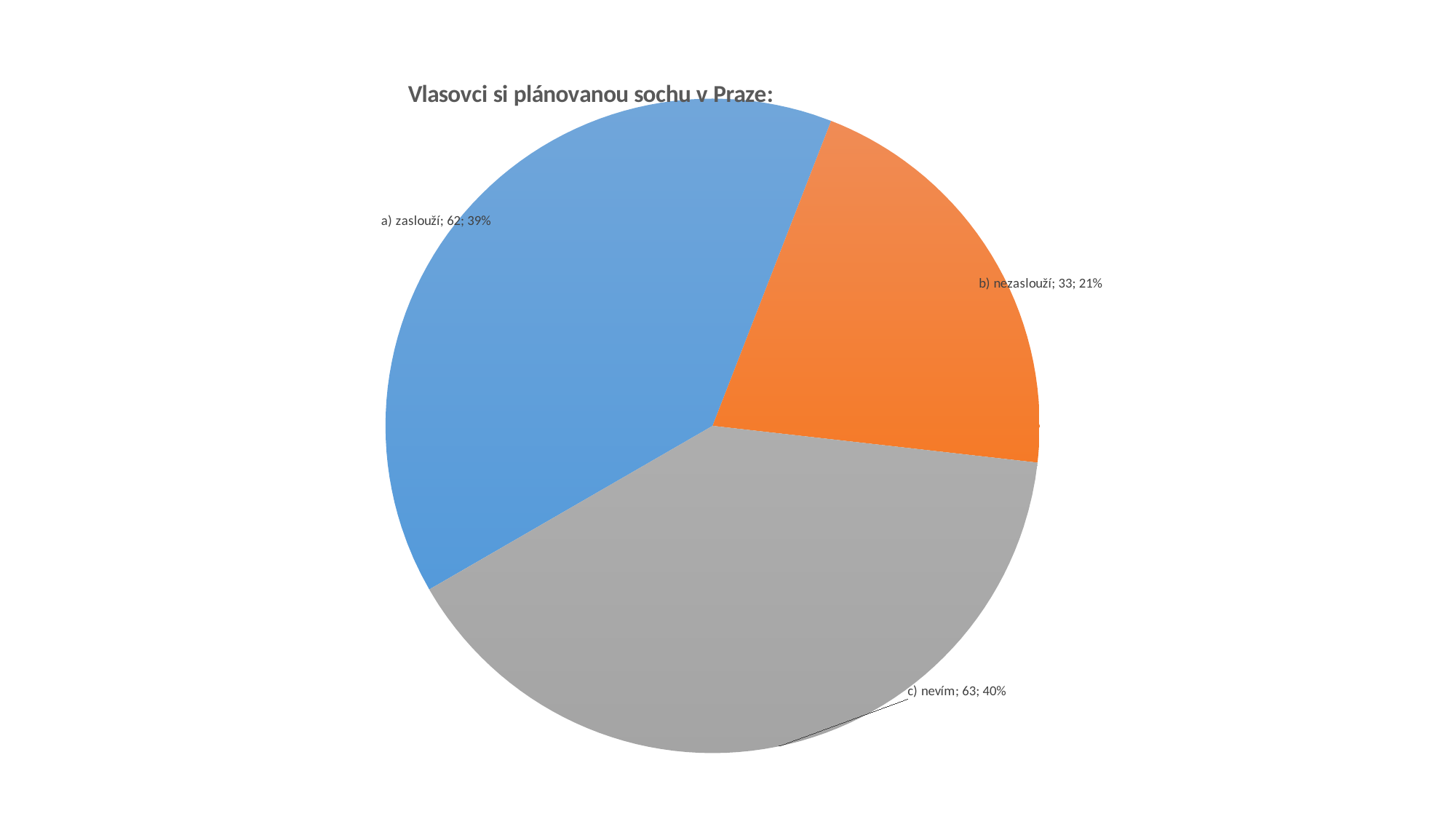
What share of the pie does b) nezaslouží represent? 21% What kind of chart is shown on the slide? pie chart What is the title of the chart? Vlasovci si plánovanou sochu v Praze: What is the total of all three slice values? 158 Which category has the largest slice? c) nevím What is the difference between the values for c) nevím and b) nezaslouží? 30 What is the value for b) nezaslouží? 33 Which category has the smallest slice? b) nezaslouží What is the value for c) nevím? 63 What is the value for a) zaslouží? 62 What share of the pie does c) nevím represent? 40% How many slices does the pie chart have? 3